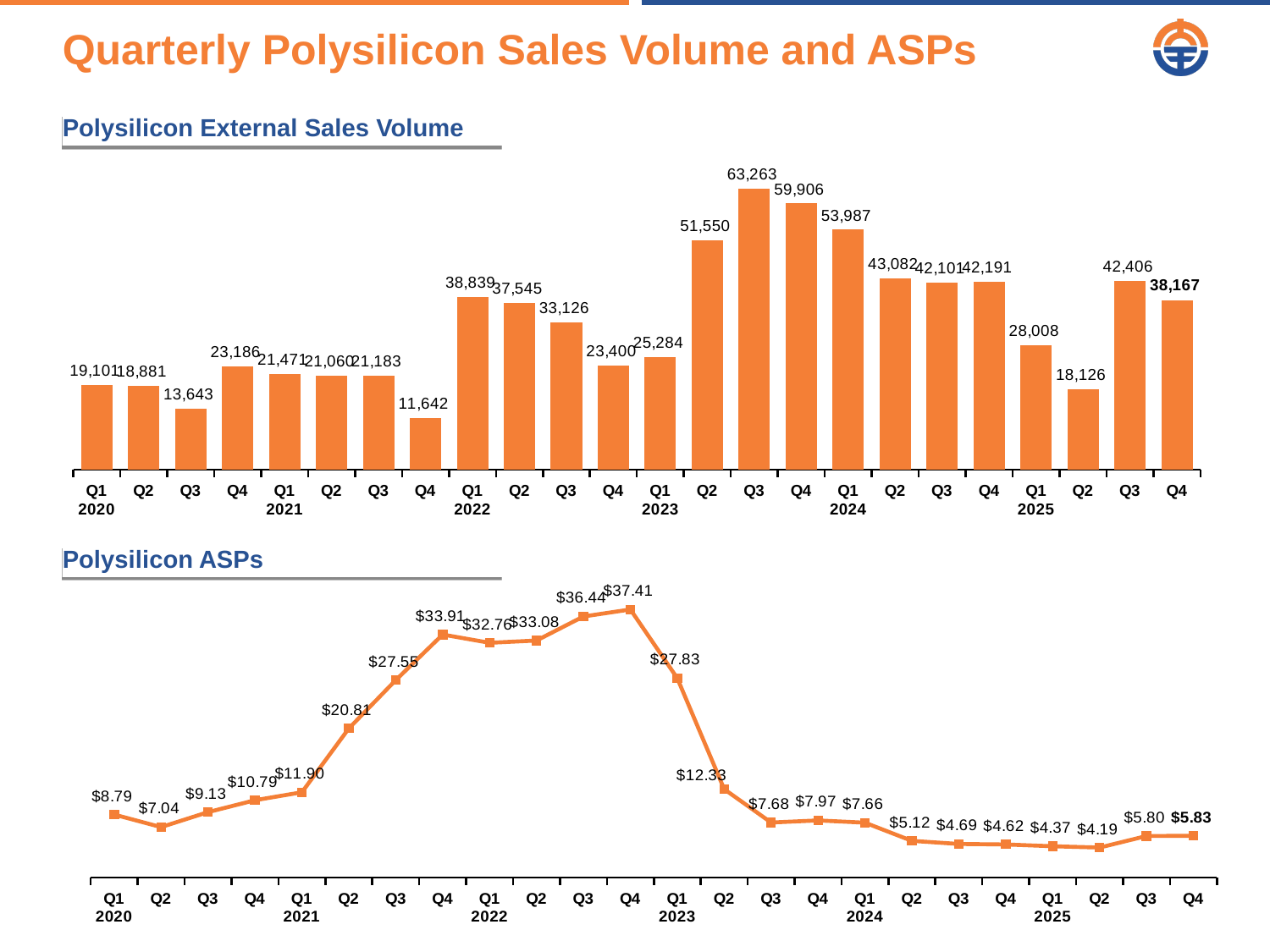
In the Polysilicon External Sales Volume chart, what is the difference between the Q3 2025 and Q4 2025 sales volumes? 4,239 In the Polysilicon ASPs chart, did the ASP rise or fall from Q1 2021 to Q4 2022? Rise How many quarters are plotted in the Polysilicon External Sales Volume chart? 24 In the Polysilicon ASPs chart, which quarter had the lowest ASP? Q2 2025 What kind of chart is the Polysilicon External Sales Volume chart? Bar chart In the Polysilicon External Sales Volume chart, which quarter had the highest sales volume? Q3 2023 In the Polysilicon External Sales Volume chart, which quarter had the larger sales volume, Q1 2022 or Q2 2022? Q1 2022 In the Polysilicon External Sales Volume chart, which quarter had the lowest sales volume? Q4 2021 In the Polysilicon External Sales Volume chart, what was the sales volume in Q3 2023? 63,263 In the Polysilicon ASPs chart, which quarter had the highest ASP? Q4 2022 What kind of chart is the Polysilicon ASPs chart? Line chart In the Polysilicon ASPs chart, what was the ASP in Q4 2022? $37.41